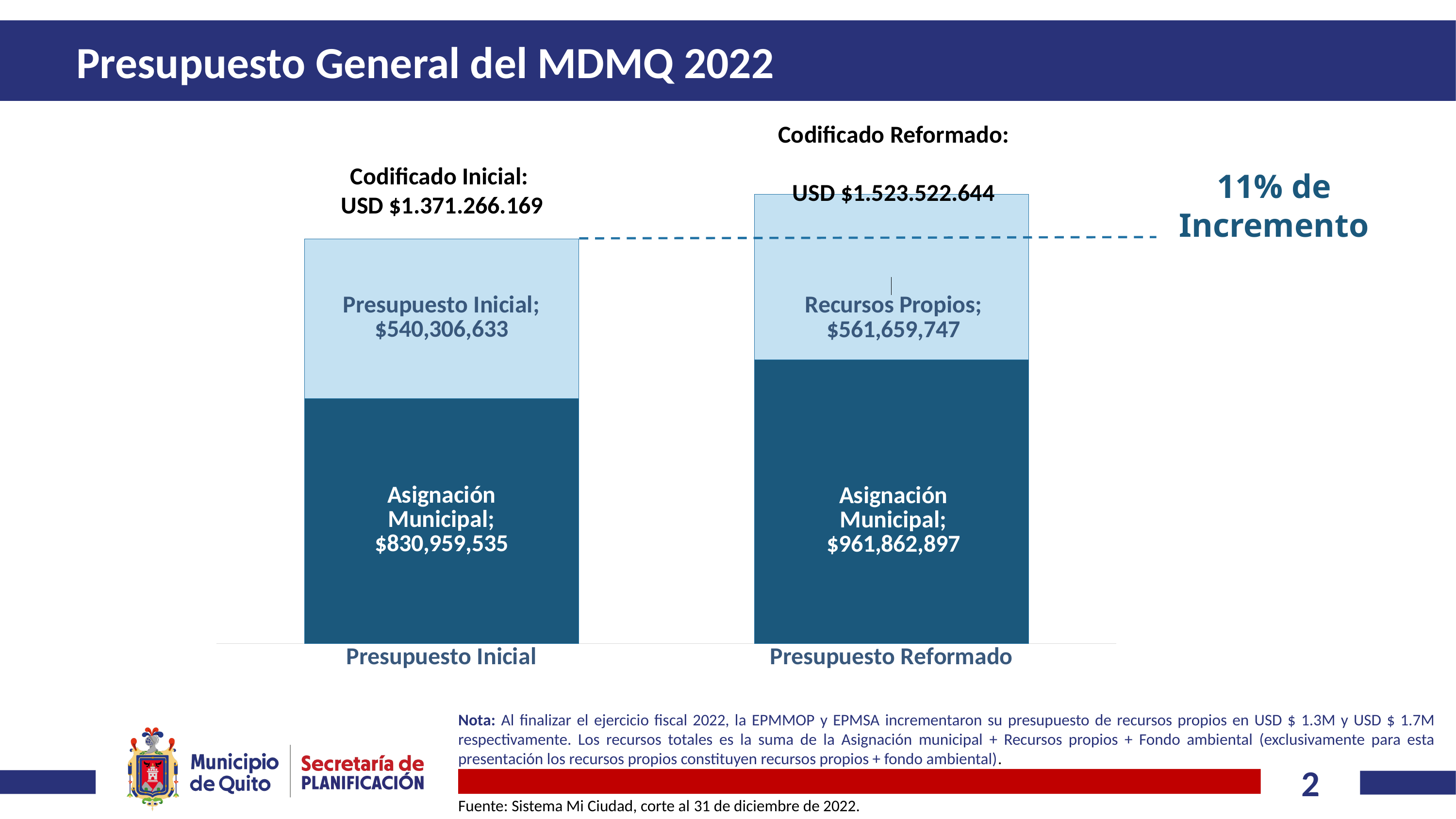
What is the value of Recursos Propios in the Presupuesto Reformado bar? $561,659,747 What is the value of the Presupuesto Inicial segment in the Presupuesto Inicial bar? $540,306,633 What percentage increase is annotated on the chart between the two bars? 11% de Incremento What kind of chart is shown on the slide? Stacked bar chart What is the value of Asignación Municipal in the Presupuesto Reformado bar? $961,862,897 What is the difference between Recursos Propios in Presupuesto Reformado and the Presupuesto Inicial segment in Presupuesto Inicial? $21,353,114 What is the total of the Presupuesto Reformado bar (Codificado Reformado)? USD $1.523.522.644 What is the difference between Asignación Municipal in Presupuesto Reformado and in Presupuesto Inicial? $130,903,362 What is the total of the Presupuesto Inicial bar (Codificado Inicial)? USD $1.371.266.169 What is the value of Asignación Municipal in the Presupuesto Inicial bar? $830,959,535 How many bars (categories) are shown on the x axis of the chart? 2 Which bar has the larger Asignación Municipal value, Presupuesto Inicial or Presupuesto Reformado? Presupuesto Reformado